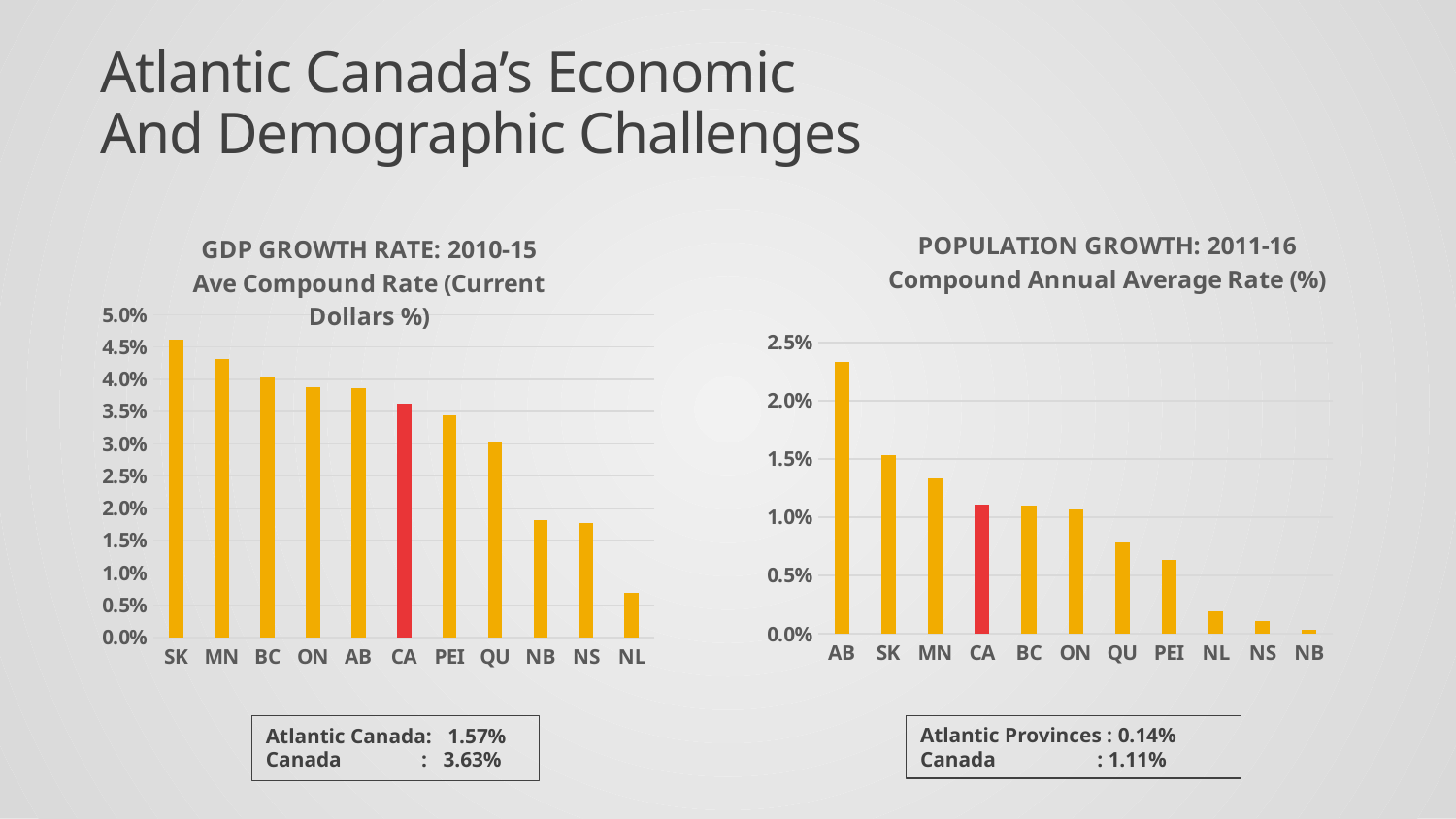
What kind of chart is the Population Growth chart on the right? bar chart In the Population Growth chart on the right, do the values rise or fall from left to right along the x axis? fall In the GDP Growth Rate chart on the left, what colour is the CA bar? red In the GDP Growth Rate chart on the left, which category has the lowest value? NL In the Population Growth chart on the right, which category has the lowest value? NB In the GDP Growth Rate chart on the left, is the value for SK greater or less than 4.0%? greater In the Population Growth chart on the right, is the value for AB greater or less than 2.0%? greater How many categories are shown on the x axis of the GDP Growth Rate chart on the left? 11 In the Population Growth chart on the right, which category has the highest value? AB In the GDP Growth Rate chart on the left, is the value for NL greater or less than 1.0%? less In the GDP Growth Rate chart on the left, which province has the highest growth rate? SK